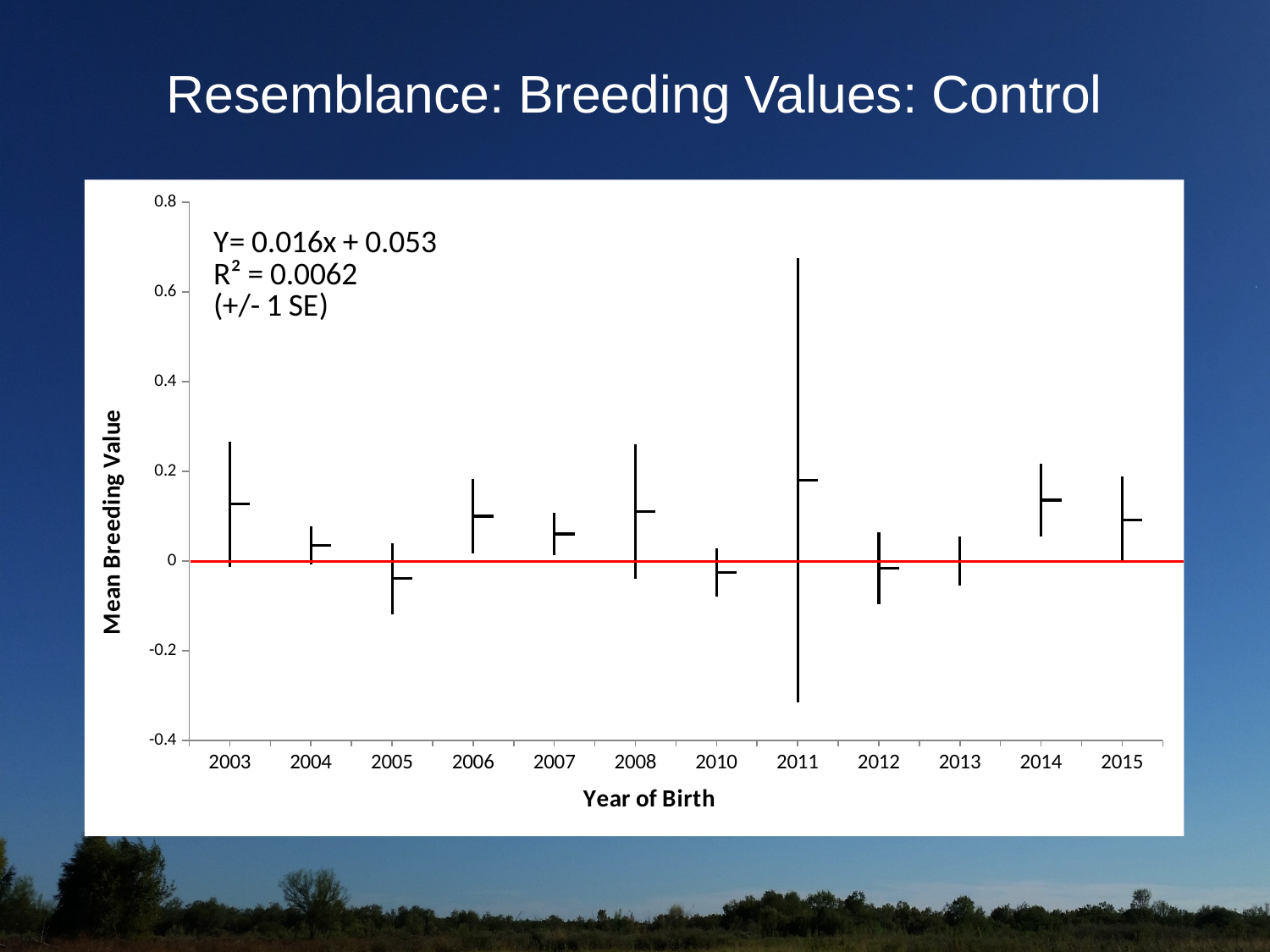
Which has the larger mean breeding value, 2006 or 2007? 2006 Is the mean breeding value for 2011 greater or less than 0? greater How many years of birth are shown on the x axis of the chart? 12 Is the lower end of the error bar for 2011 greater or less than -0.2? less Is the mean breeding value for 2003 greater or less than 0.2? less Which year of birth has the widest error bar (+/- 1 SE)? 2011 What is the title of the chart's y axis? Mean Breeding Value What is the title of the chart's x axis? Year of Birth Which has the larger mean breeding value, 2003 or 2004? 2003 Which year of birth has the highest mean breeding value? 2011